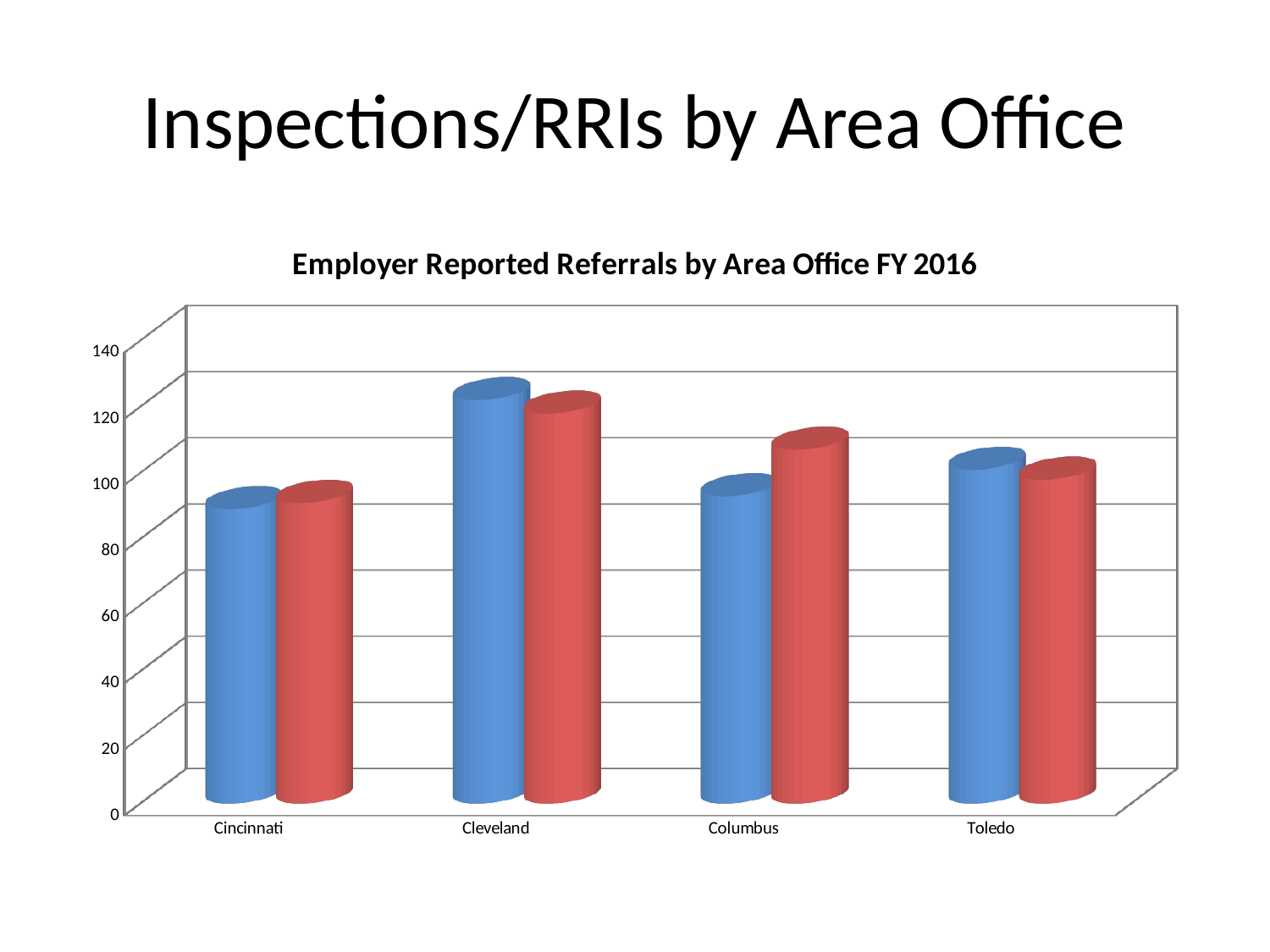
Which area office has the tallest blue bar? Cleveland Is the blue bar for Cleveland greater or less than 100? greater Which is larger, the red bar for Columbus or the red bar for Cincinnati? Columbus Is the blue bar for Cincinnati greater or less than 100? less What colours are the two sets of bars in the chart? blue and red How many bars are plotted for each area office? 2 How many area offices are shown on the x axis of the chart? 4 Is the red bar for Cleveland greater or less than 140? less Which area office has the tallest red bar? Cleveland Which is larger, the blue bar for Cleveland or the blue bar for Cincinnati? Cleveland What is the title of the chart? Employer Reported Referrals by Area Office FY 2016 What kind of chart is shown on the slide? bar chart